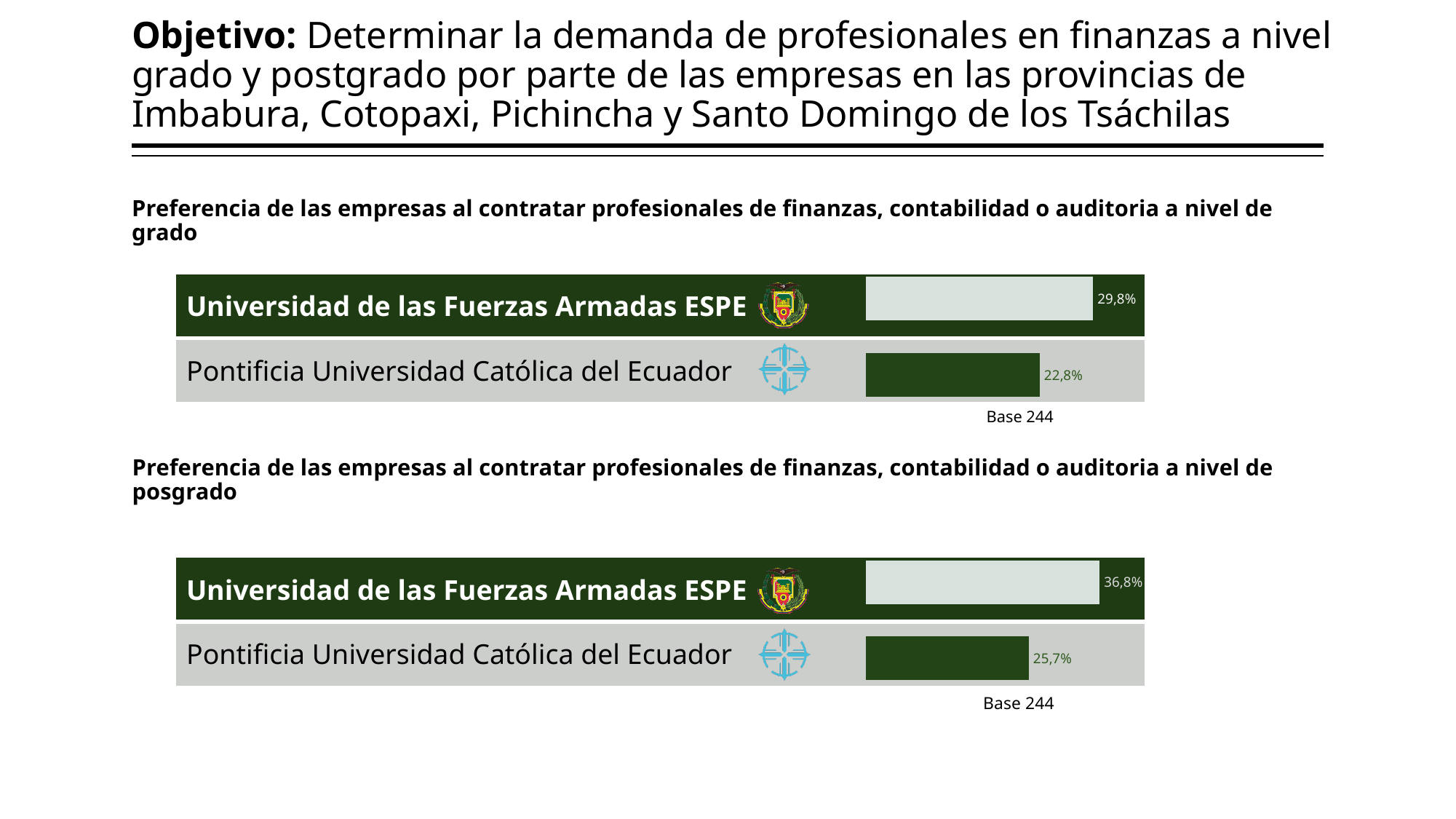
In the top chart (nivel de grado), what is the difference between the values for Universidad de las Fuerzas Armadas ESPE and Pontificia Universidad Católica del Ecuador? 7,0% In the bottom chart (nivel de posgrado), what is the difference between the values for Universidad de las Fuerzas Armadas ESPE and Pontificia Universidad Católica del Ecuador? 11,1% In the top chart (nivel de grado), what is the value for Universidad de las Fuerzas Armadas ESPE? 29,8% What kind of chart is the bottom chart (nivel de posgrado)? Bar chart In the top chart (nivel de grado), what is the value for Pontificia Universidad Católica del Ecuador? 22,8% What base (sample size) is stated below the top chart (nivel de grado)? Base 244 How many universities are shown in the top chart (nivel de grado)? 2 In the bottom chart (nivel de posgrado), which university has the lowest value? Pontificia Universidad Católica del Ecuador In the top chart (nivel de grado), which university has the highest value? Universidad de las Fuerzas Armadas ESPE In the bottom chart (nivel de posgrado), which is larger: the value for Universidad de las Fuerzas Armadas ESPE or for Pontificia Universidad Católica del Ecuador? Universidad de las Fuerzas Armadas ESPE In the bottom chart (nivel de posgrado), what is the value for Universidad de las Fuerzas Armadas ESPE? 36,8% In the bottom chart (nivel de posgrado), what is the value for Pontificia Universidad Católica del Ecuador? 25,7%